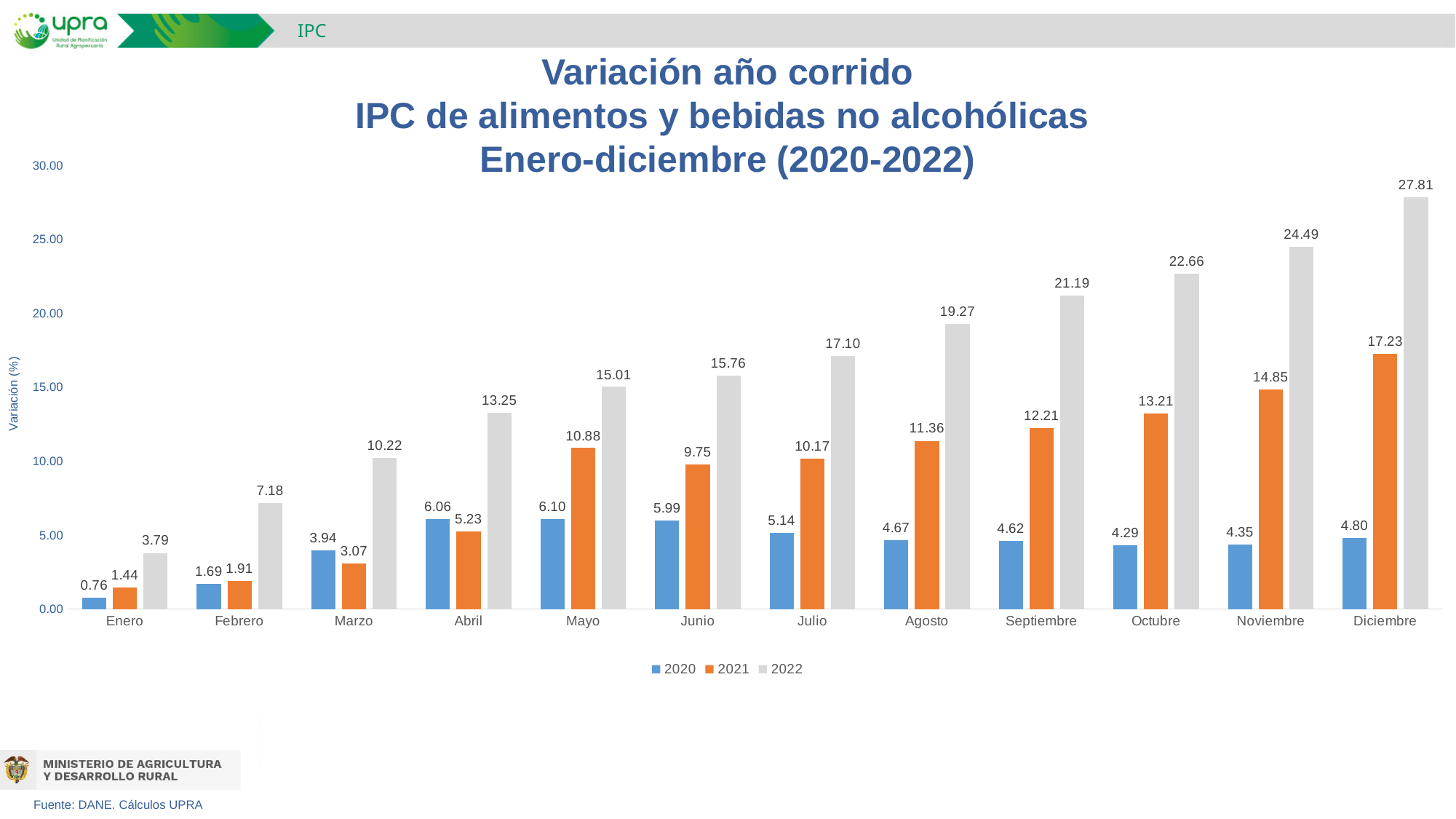
In which month is the 2020 value lowest? Enero What kind of chart is shown on the slide? bar chart What is the value for 2022 in Diciembre? 27.81 Is the value for 2022 in Noviembre greater or less than 20.00? greater In which month does the 2022 series reach its highest value? Diciembre What is the difference between the 2022 and 2021 values in Diciembre? 10.58 What is the value for 2020 in Abril? 6.06 In Marzo, which series has the larger value, 2020 or 2021? 2020 How many series does the legend list? 3 Do the 2022 values rise or fall from Enero to Diciembre? rise What is the value for 2021 in Mayo? 10.88 How many months are shown on the x axis? 12